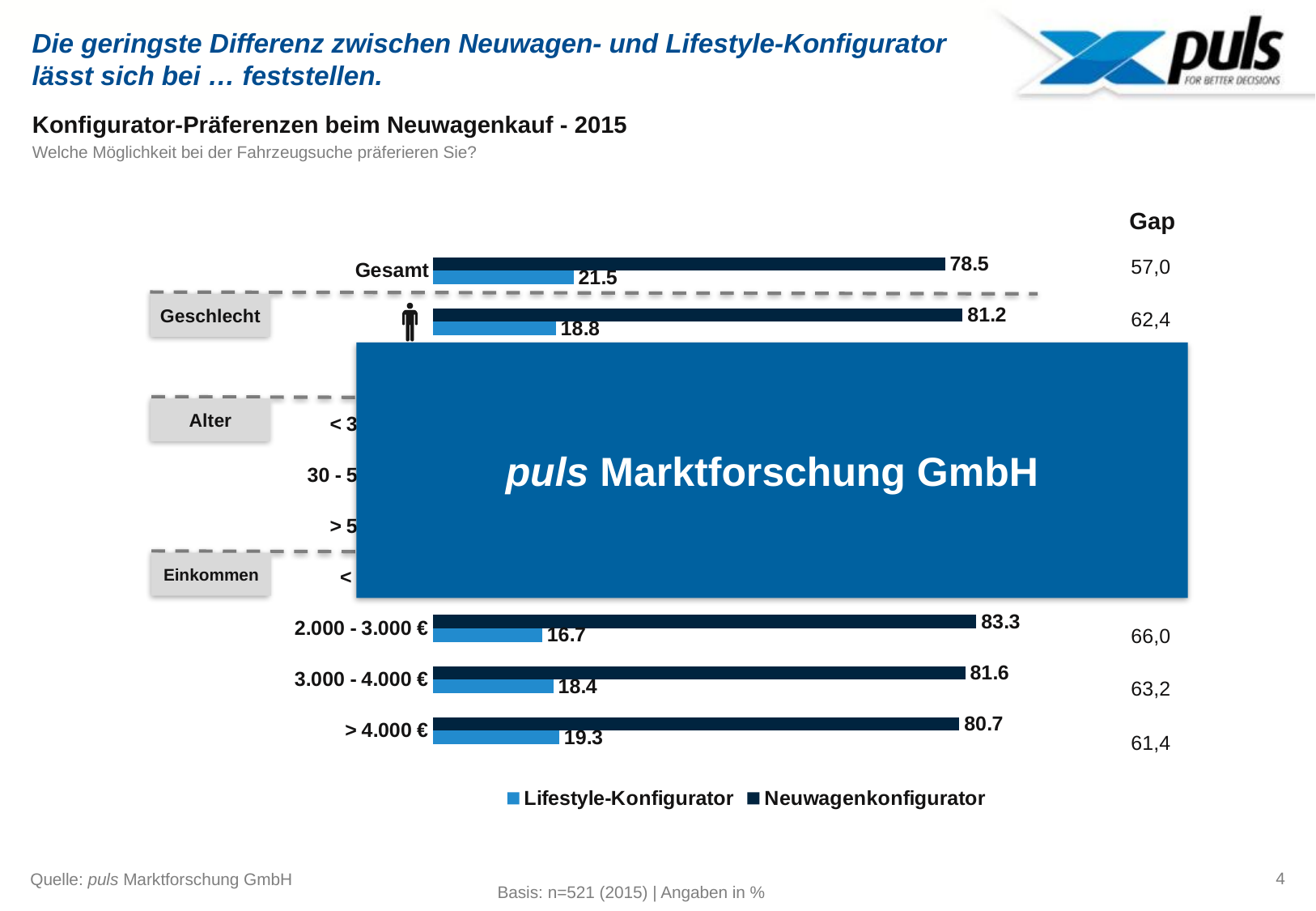
What is the Lifestyle-Konfigurator value for the 3.000 - 4.000 € income group? 18.4 What is the Lifestyle-Konfigurator value for Gesamt? 21.5 How many series does the legend list? 2 What is the Neuwagenkonfigurator value for Gesamt? 78.5 What is the Gap value shown for the > 4.000 € income group? 61,4 Among the visible income groups (2.000 - 3.000 €, 3.000 - 4.000 €, > 4.000 €), which has the highest Neuwagenkonfigurator value? 2.000 - 3.000 € Which legend entry is shown in the dark navy colour? Neuwagenkonfigurator What is the Neuwagenkonfigurator value for the 2.000 - 3.000 € income group? 83.3 What type of chart is shown on the slide? bar chart What is the difference between the Neuwagenkonfigurator and Lifestyle-Konfigurator values for the > 4.000 € group? 61.4 Which is larger for the 2.000 - 3.000 € group: the Lifestyle-Konfigurator value or the Neuwagenkonfigurator value? Neuwagenkonfigurator Among the visible income groups (2.000 - 3.000 €, 3.000 - 4.000 €, > 4.000 €), which has the lowest Lifestyle-Konfigurator value? 2.000 - 3.000 €